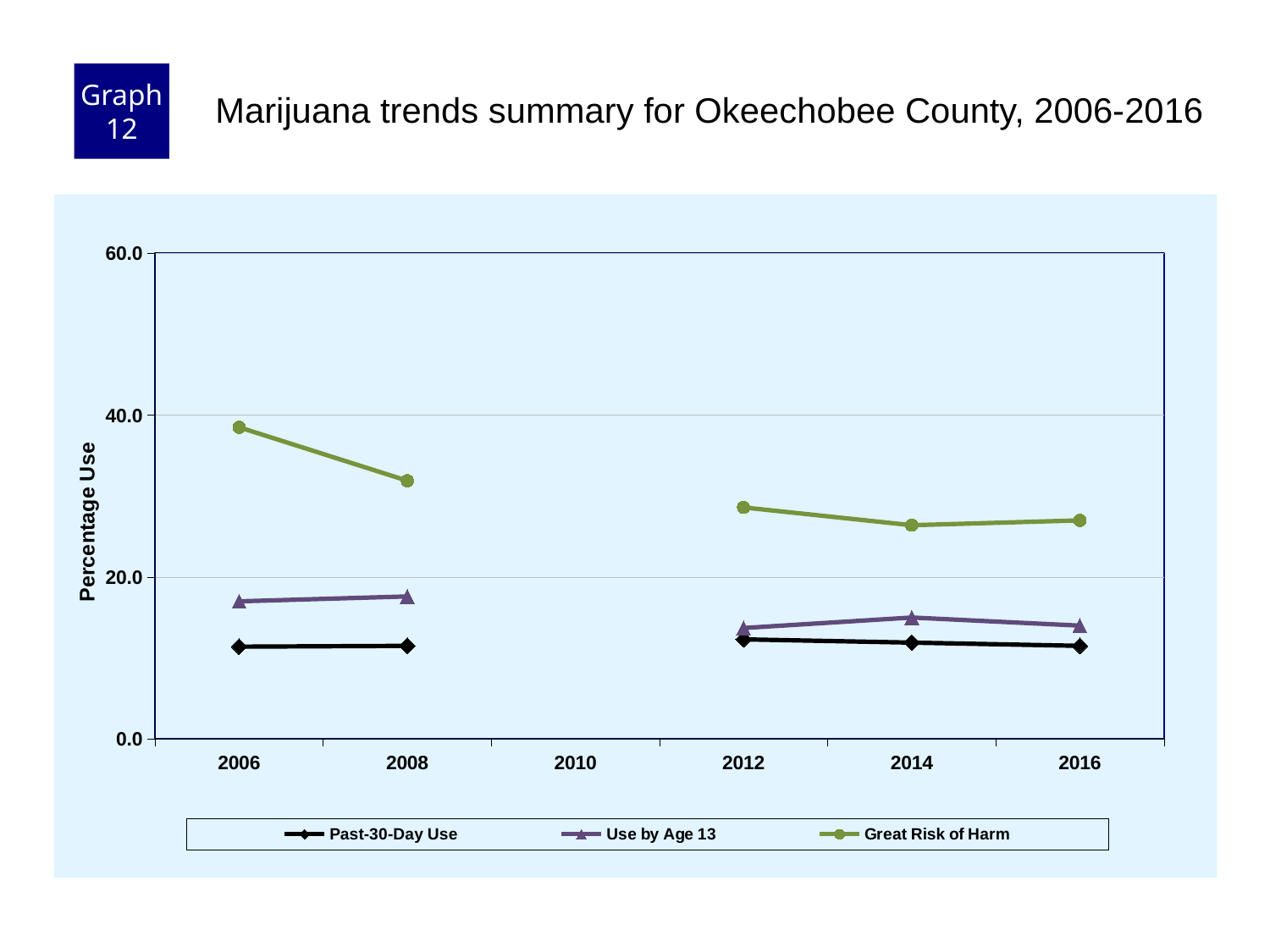
How many years are labelled on the x axis? 6 How many series does the legend list? 3 Is the value for Use by Age 13 in 2014 greater or less than 20.0? less Is the value for Past-30-Day Use in 2006 greater or less than 20.0? less In which year is the Great Risk of Harm series at its highest? 2006 Which series is listed first in the legend? Past-30-Day Use What is the label on the y axis? Percentage Use Does the Great Risk of Harm series rise or fall from 2006 to 2008? fall Is the value for Great Risk of Harm in 2008 greater or less than 20.0? greater In 2012, which is larger: Great Risk of Harm or Past-30-Day Use? Great Risk of Harm What kind of chart is shown on the slide? line chart